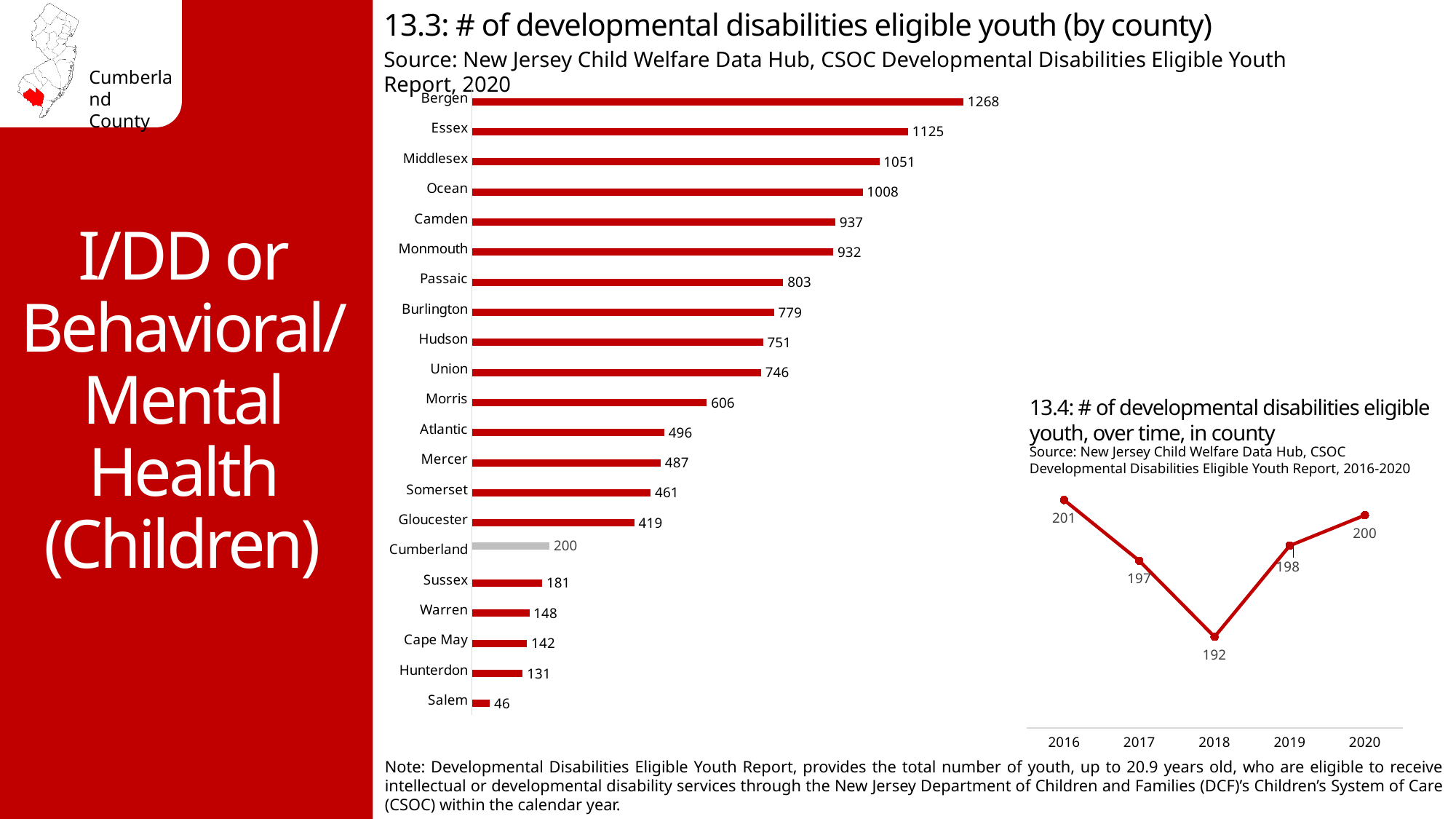
In chart 13.3 (# of developmental disabilities eligible youth by county), which is larger, Atlantic or Mercer? Atlantic In chart 13.3 (# of developmental disabilities eligible youth by county), which county's bar is shown in grey rather than red? Cumberland In chart 13.4 (# of developmental disabilities eligible youth over time in county), what is the value for 2018? 192 In chart 13.3 (# of developmental disabilities eligible youth by county), how many counties are shown? 21 In chart 13.3 (# of developmental disabilities eligible youth by county), which county has the lowest value? Salem In chart 13.3 (# of developmental disabilities eligible youth by county), what is the value for Cumberland? 200 In chart 13.3 (# of developmental disabilities eligible youth by county), what is the value for Passaic? 803 In chart 13.3 (# of developmental disabilities eligible youth by county), what is the difference between Bergen and Essex? 143 In chart 13.4 (# of developmental disabilities eligible youth over time in county), what is the difference between 2020 and 2018? 8 In chart 13.3 (# of developmental disabilities eligible youth by county), which county has the highest value? Bergen What kind of chart is chart 13.3 (# of developmental disabilities eligible youth by county)? Bar chart In chart 13.4 (# of developmental disabilities eligible youth over time in county), which year has the highest value? 2016